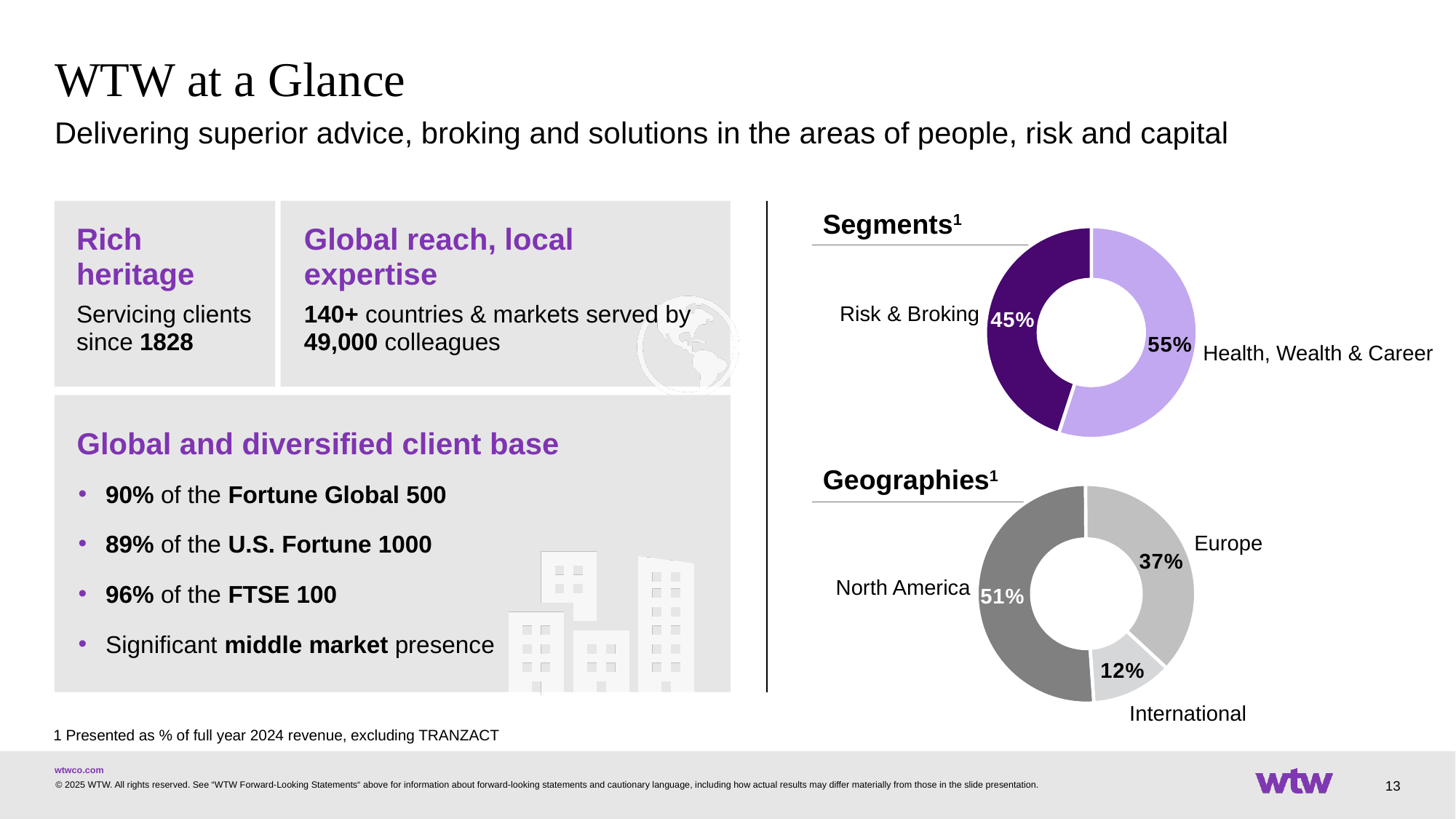
In the Geographies chart, what share of revenue is Europe? 37% In the Geographies chart, how many geographies are shown? 3 In the Geographies chart, which geography has the smallest share? International In the Geographies chart, what is the difference in percentage points between North America and Europe? 14 percentage points In the Geographies chart, which geography has the largest share? North America In the Segments chart, what share of revenue is Health, Wealth & Career? 55% In the Segments chart, which segment has the larger share? Health, Wealth & Career In the Geographies chart, what share of revenue is North America? 51% In the Segments chart, what share of revenue is Risk & Broking? 45% What kind of chart is the Segments chart? Donut (pie) chart In the Geographies chart, what share of revenue is International? 12% In the Segments chart, what is the difference in percentage points between Health, Wealth & Career and Risk & Broking? 10 percentage points